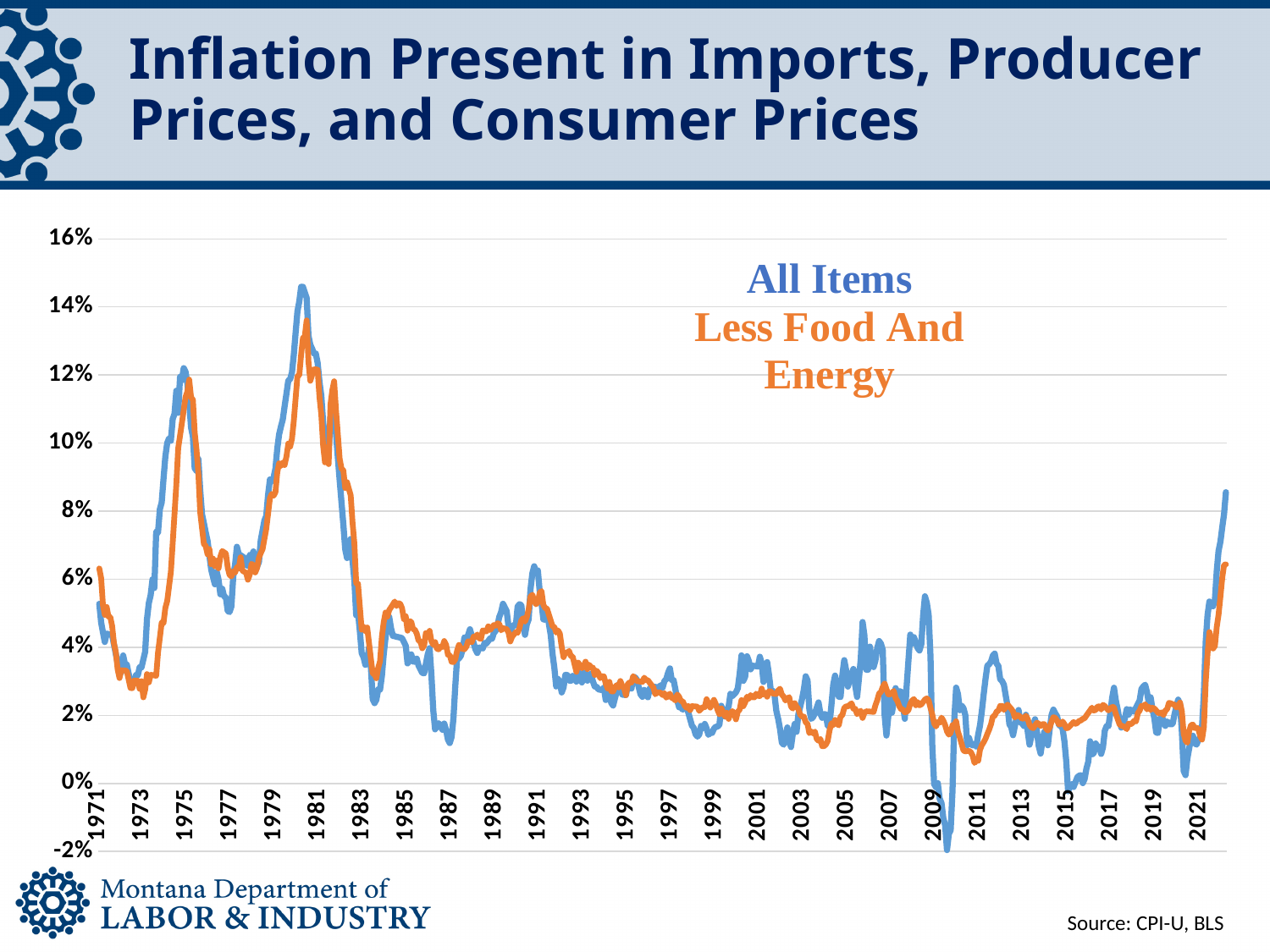
What kind of chart is shown on the slide? line chart What source is cited for the chart data? CPI-U, BLS What is the highest value shown on the vertical axis? 16% Is the lowest value of the All Items series around 2009 greater or less than 0%? less Is the peak value of the All Items series around 1980 greater or less than 14%? greater Which series has the lower value around 2009, All Items or Less Food And Energy? All Items Is the final value of the All Items series at the right end of the chart greater or less than 8%? greater How many series does the chart show? 2 Does the All Items series rise or fall between 1980 and 1983? fall Which series reaches the higher peak around 1980, All Items or Less Food And Energy? All Items Which series is drawn in orange? Less Food And Energy